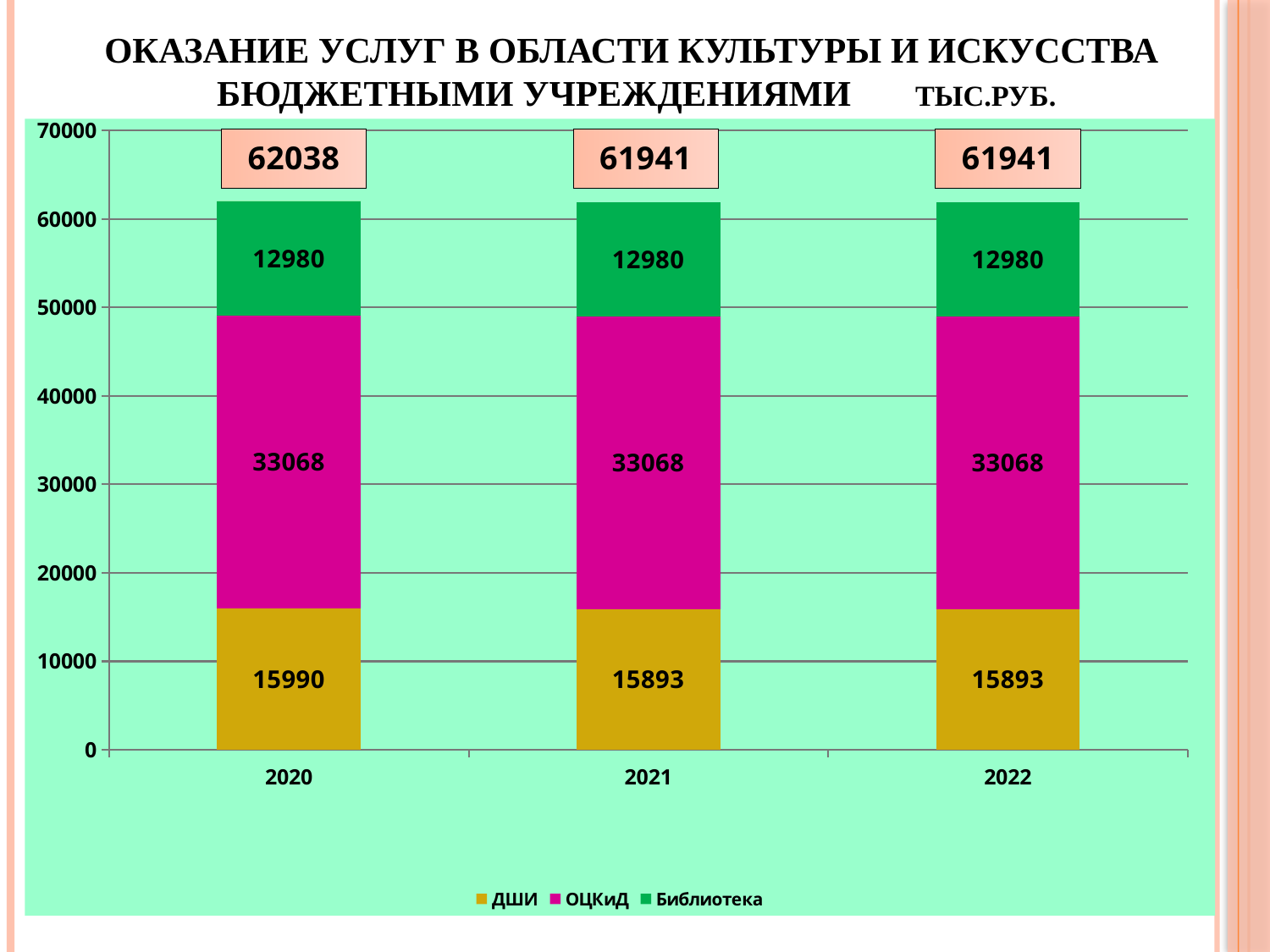
What is the value for Библиотека in 2022? 12980 What kind of chart is shown? Stacked bar chart What is the value for ОЦКиД in 2021? 33068 Which is larger in 2021: ОЦКиД or Библиотека? ОЦКиД What is the total of the stacked bar for 2022? 61941 What is the total of the stacked bar for 2020? 62038 What is the difference between the ДШИ values for 2020 and 2021? 97 How many years are shown on the x axis? 3 What is the value for ДШИ in 2020? 15990 Which series is shown in green? Библиотека Which year has the highest total? 2020 How many series does the legend list? 3